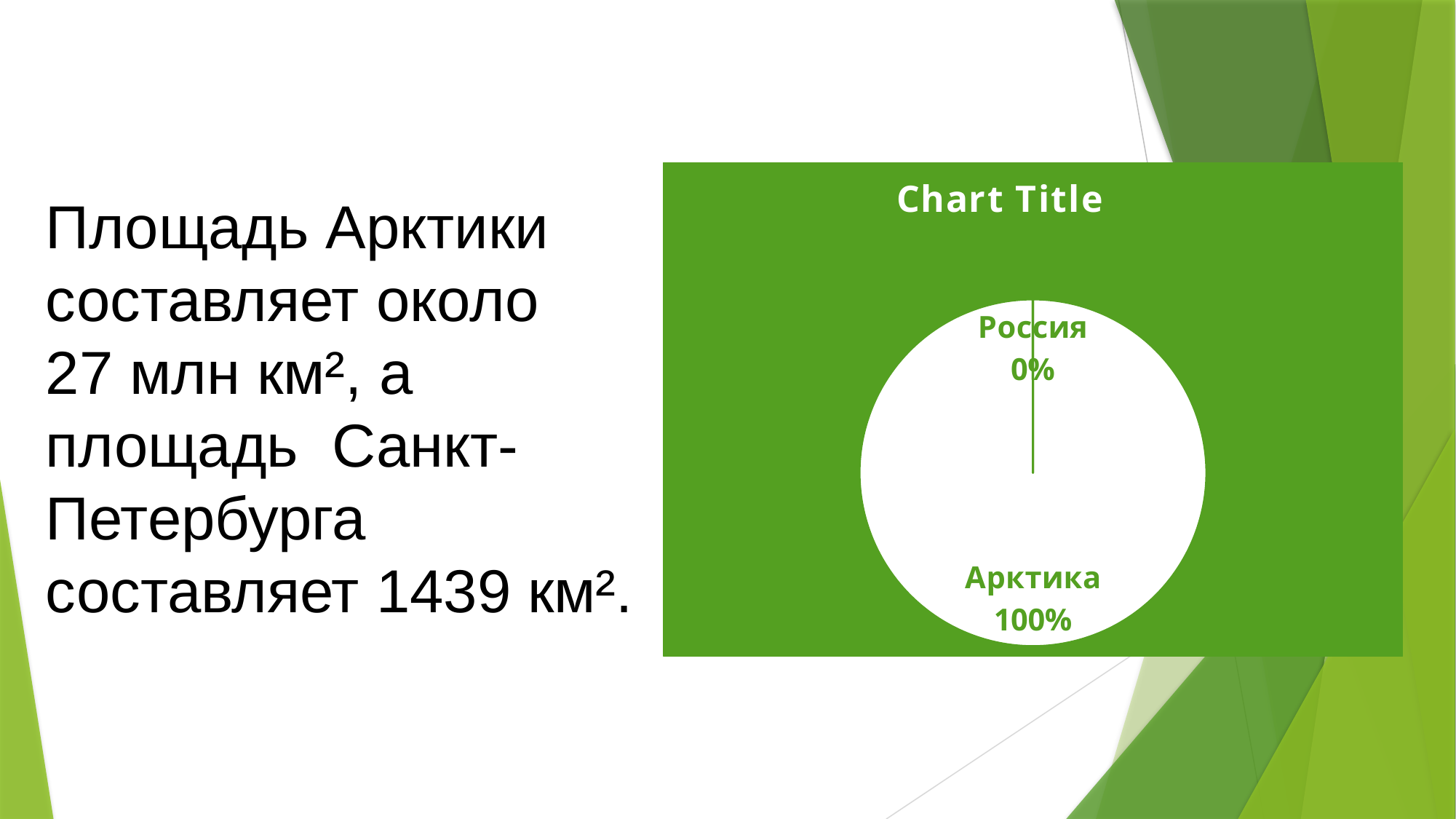
What is the title of the chart? Chart Title What kind of chart is shown on the slide? pie chart What share of the pie does Арктика have? 100% Which slice of the pie is the smallest? Россия Is the share for Арктика greater or less than 50%? greater Is the share for Россия greater or less than 50%? less What share of the pie does Россия have? 0% What is the difference between the share for Арктика and the share for Россия? 100% Which slice of the pie is the largest? Арктика How many slices are labelled on the pie chart? 2 Which is larger, the share for Арктика or the share for Россия? Арктика